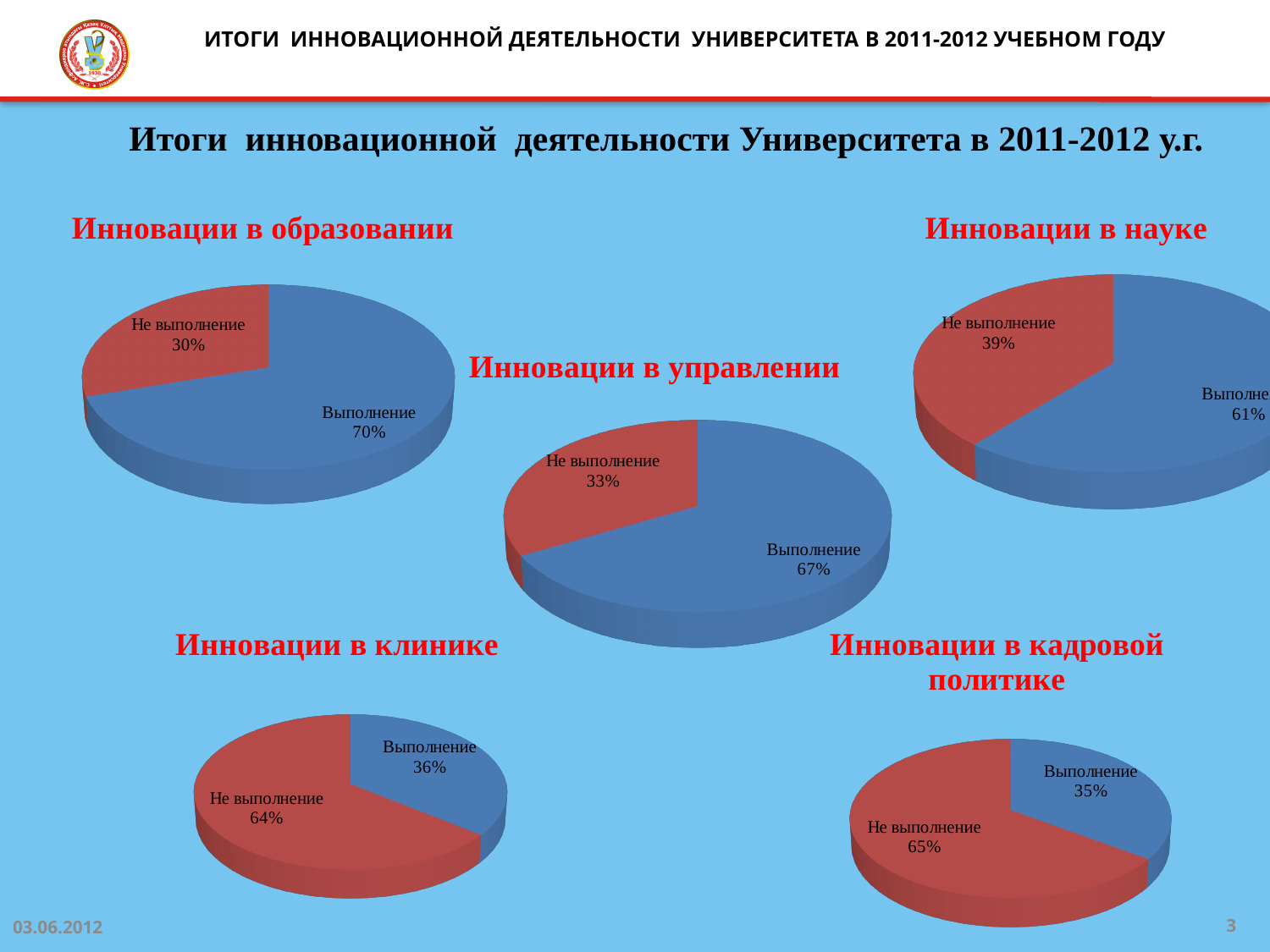
In the 'Инновации в образовании' pie chart, what is the share for 'Выполнение'? 70% How many slices does the 'Инновации в кадровой политике' pie chart have? 2 In the 'Инновации в кадровой политике' pie chart, what is the share for 'Выполнение'? 35% In the 'Инновации в клинике' pie chart, which slice is larger, 'Выполнение' or 'Не выполнение'? Не выполнение How many pie charts are shown on the slide? 5 In the 'Инновации в науке' pie chart, what is the share for 'Не выполнение'? 39% In the 'Инновации в управлении' pie chart, what is the share for 'Выполнение'? 67% What type of chart is used for 'Инновации в образовании'? Pie chart In the 'Инновации в клинике' pie chart, what is the share for 'Не выполнение'? 64% In the 'Инновации в образовании' pie chart, what is the share for 'Не выполнение'? 30% In the 'Инновации в науке' pie chart, which slice is the largest? Выполнение In the 'Инновации в управлении' pie chart, what is the difference between the 'Выполнение' and 'Не выполнение' shares? 34%